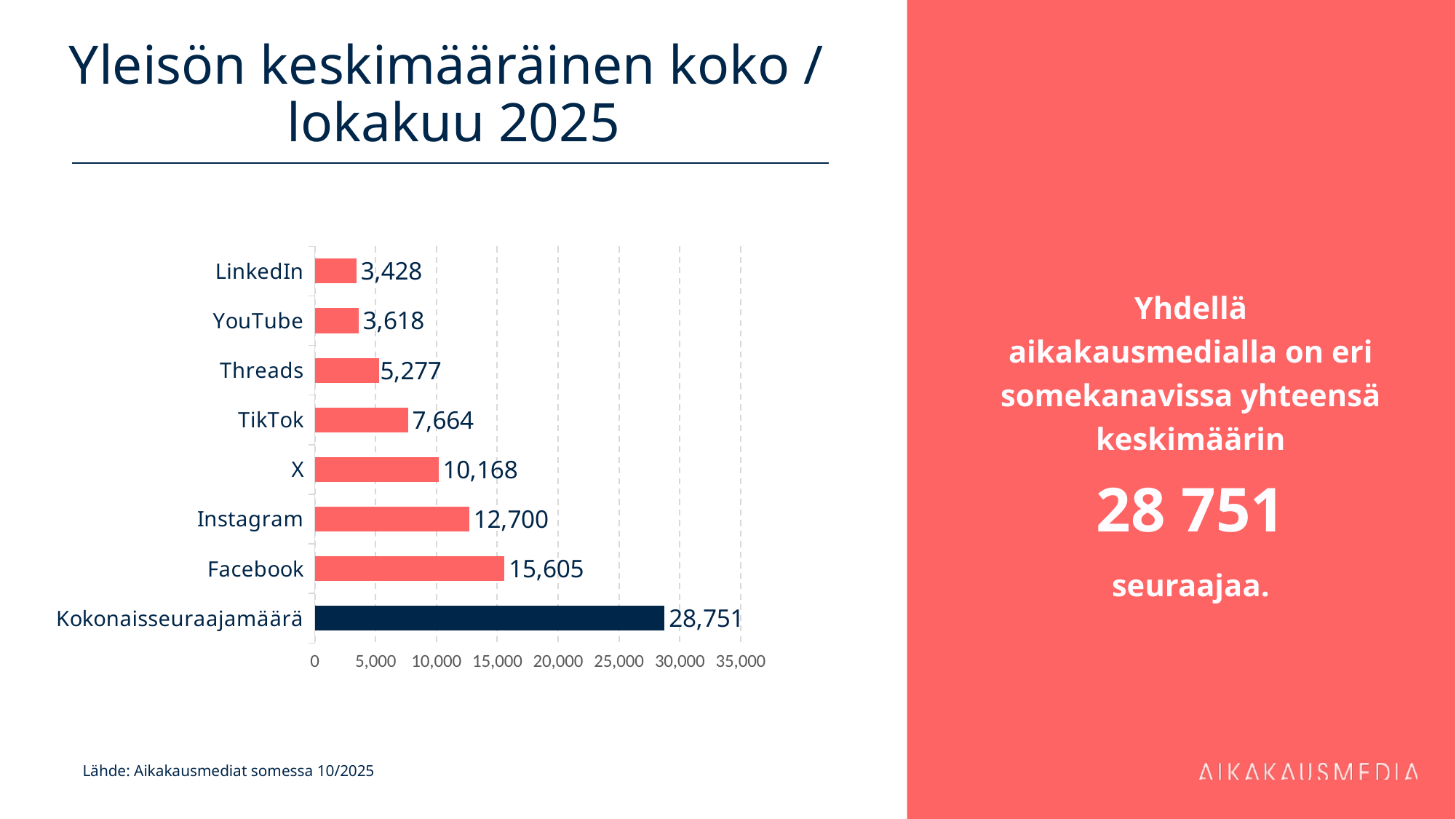
What kind of chart is shown on the slide? bar chart Is the value for Instagram greater or less than 10,000? greater How many categories are shown in the chart? 8 What is the value for TikTok? 7,664 Which category has the highest value? Kokonaisseuraajamäärä What is the value for Kokonaisseuraajamäärä? 28,751 What is the value for Facebook? 15,605 What is the difference between the values for YouTube and LinkedIn? 190 What is the difference between the values for Facebook and Instagram? 2,905 What is the title of the slide? Yleisön keskimääräinen koko / lokakuu 2025 Which category has the lowest value? LinkedIn Which is larger, the value for X or the value for Threads? X